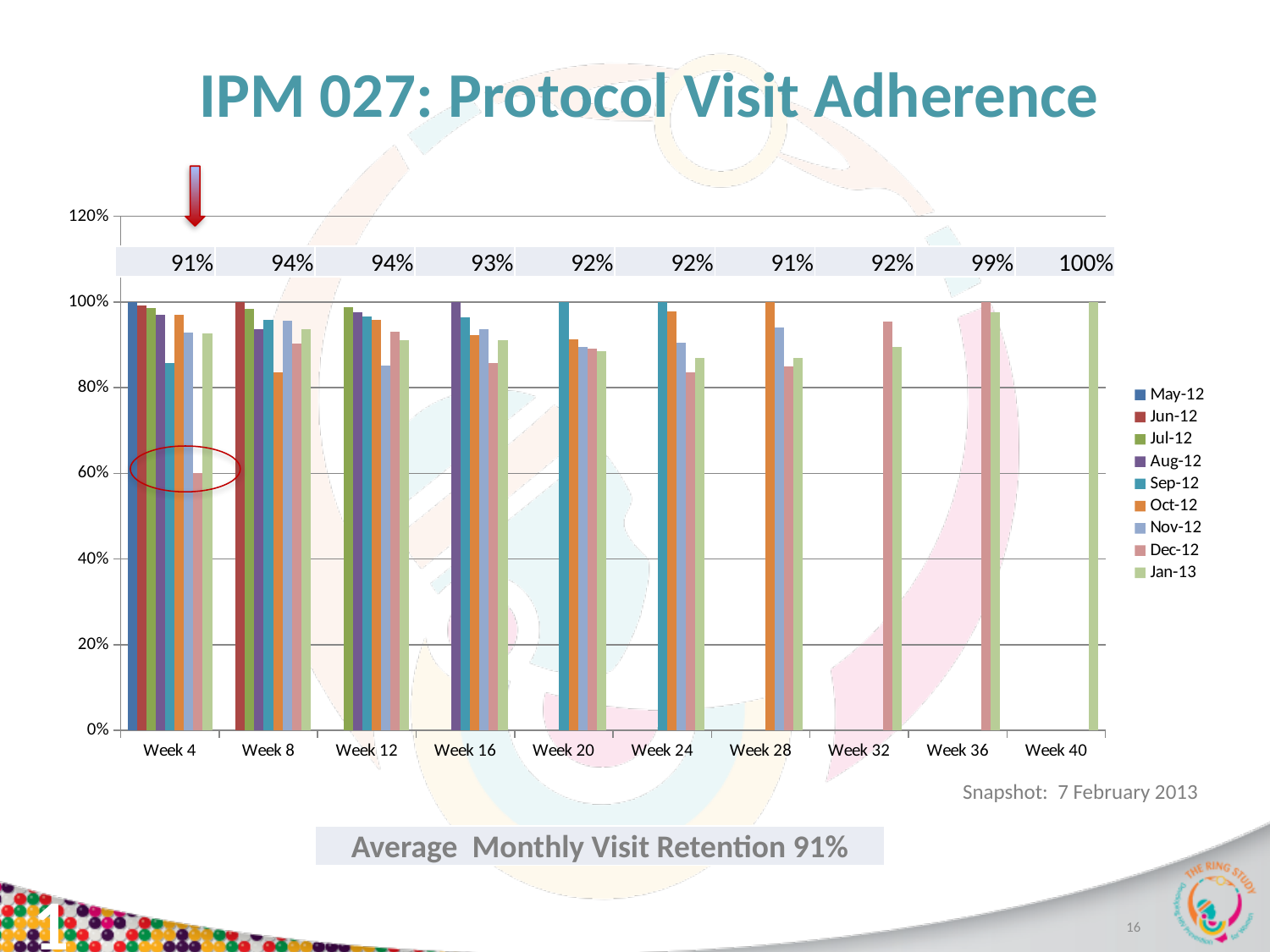
How many series does the legend list? 9 Is the Oct-12 bar for Week 8 greater or less than 100%? less In the Week 4 group, which bar is taller: May-12 or Sep-12? May-12 What is the difference between the percentages printed above Week 40 and Week 4? 9% Is the Dec-12 bar for Week 4 greater or less than 80%? less What percentage is printed above the Week 40 group? 100% What percentage is printed above the Week 4 group? 91% What type of chart is shown on the slide? bar chart What is the title of the slide? IPM 027: Protocol Visit Adherence How many week categories are shown on the x axis? 10 What percentage is printed above the Week 36 group? 99% Which week has the highest percentage printed above its group? Week 40